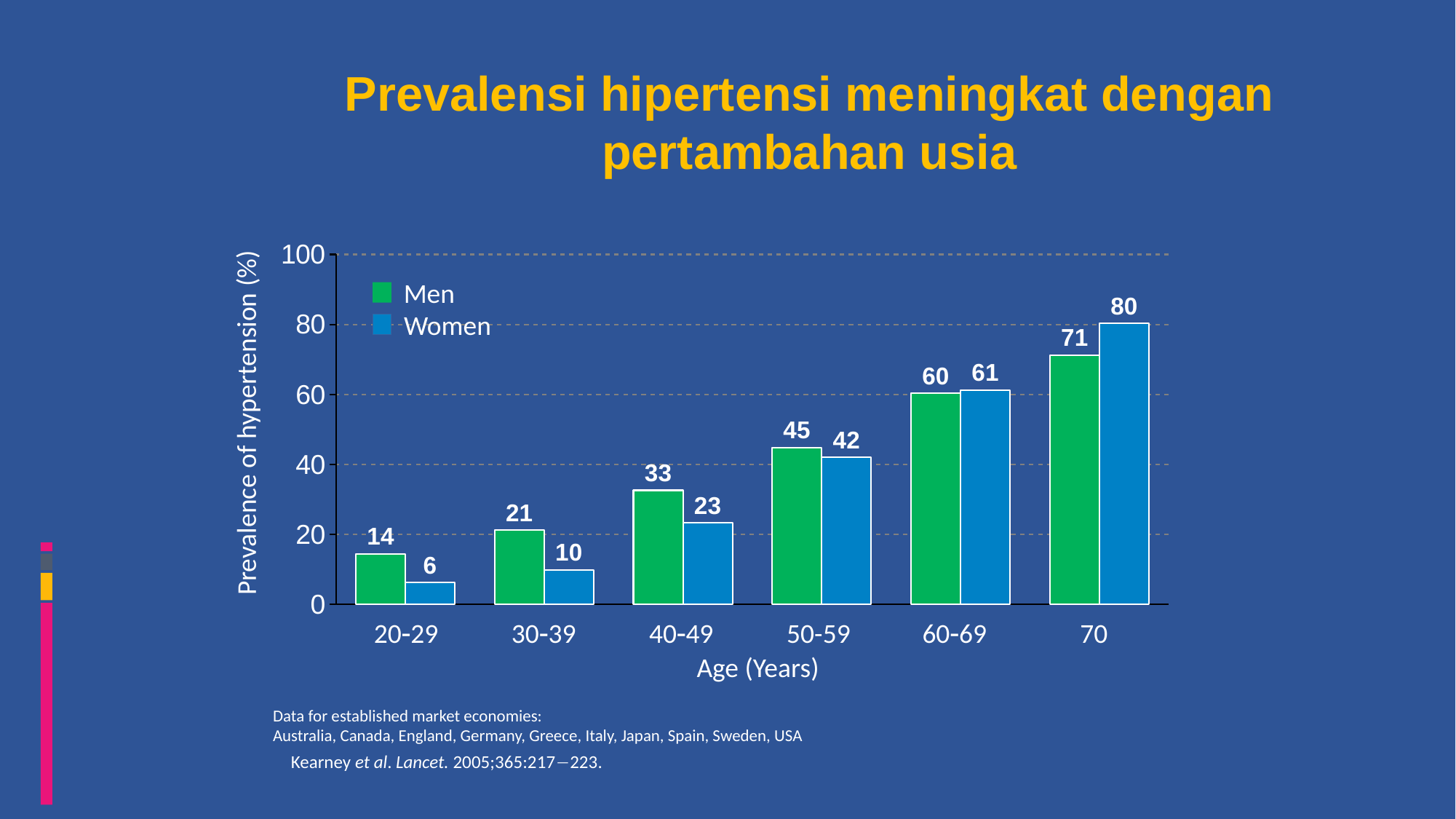
Do the values for women rise or fall as age increases along the x axis? Rise What is the difference between the men and women values in the 40-49 age group? 10 What is the prevalence of hypertension for men aged 40-49? 33 What kind of chart is shown on the slide? Bar chart What is the value for women in the 70 age group? 80 How many series does the legend list? 2 Which age group has the highest prevalence of hypertension for men? 70 How many age groups are shown on the x axis? 6 Which age group has the lowest prevalence of hypertension for women? 20-29 In the 50-59 age group, which is larger, the value for men or for women? Men Is the value for men aged 60-69 greater or less than 40? greater What is the prevalence of hypertension for women aged 20-29? 6